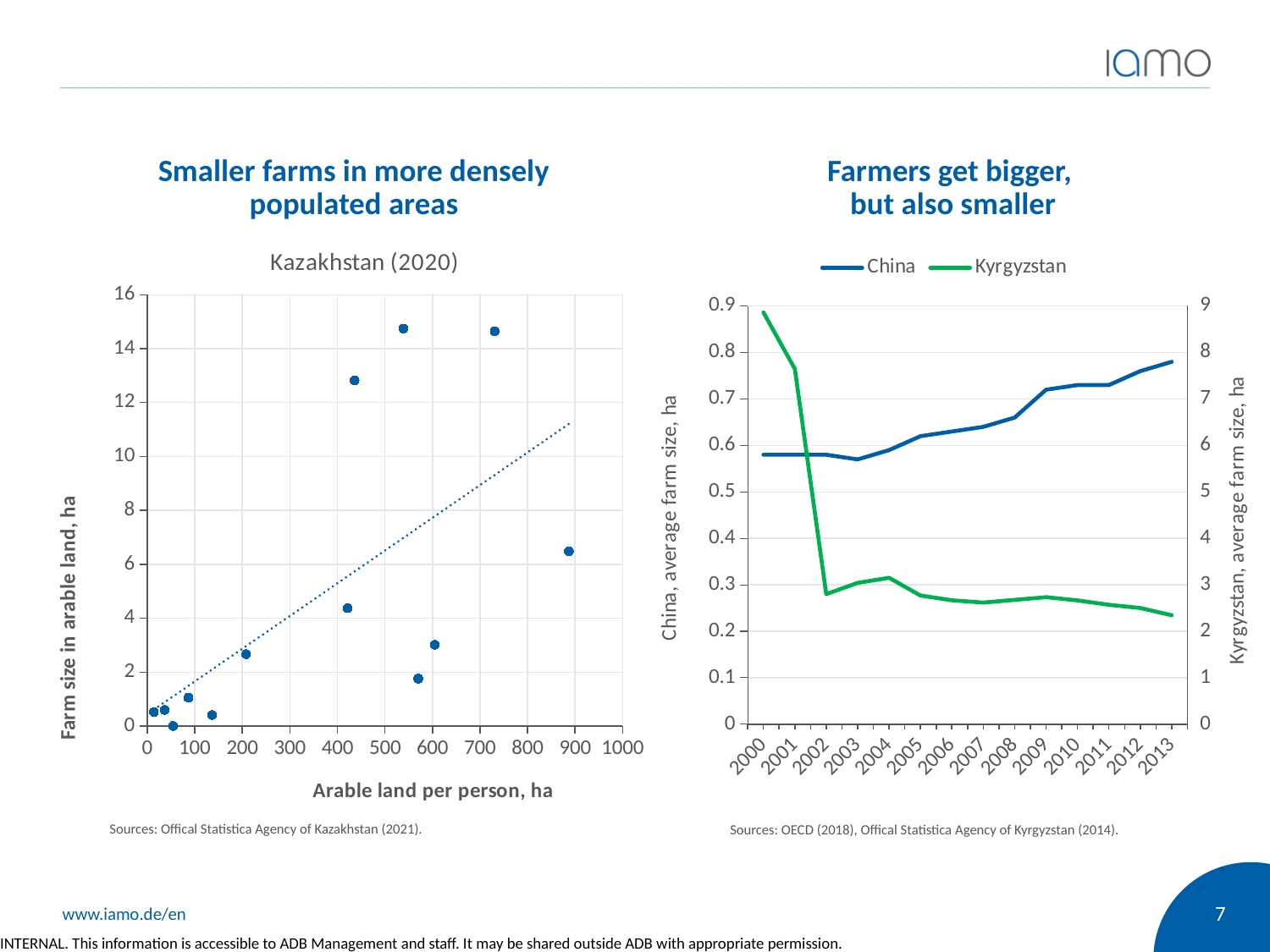
In the right chart, is the value for China in 2013 greater or less than 0.7? greater In the right chart, which year has the highest value for Kyrgyzstan? 2000 In the left chart, what is the label of the x axis? Arable land per person, ha In the right chart, does the China line rise or fall from 2000 to 2013? rise In the right chart, is the value for Kyrgyzstan in 2013 greater or less than 3? less In the right chart, is the value for Kyrgyzstan in 2000 greater or less than 8? greater In the right chart, how many series does the legend list? 2 In the right chart, does the Kyrgyzstan line rise or fall from 2000 to 2013? fall In the right chart, which colour is the Kyrgyzstan line? green What kind of chart is the left chart titled 'Kazakhstan (2020)'? scatter chart In the right chart, how many years are shown on the x axis? 14 What kind of chart is the right chart showing China and Kyrgyzstan? line chart